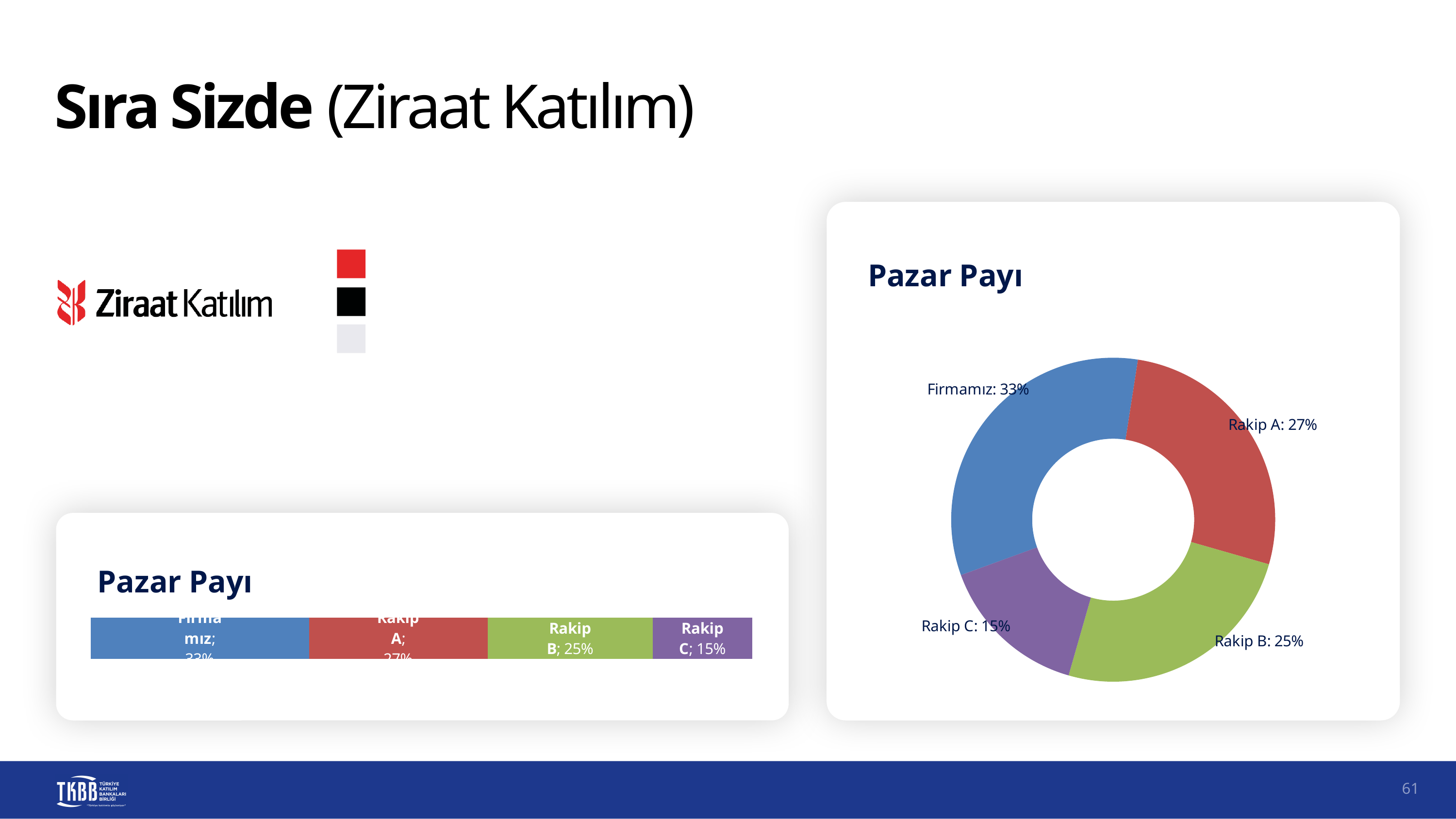
In the doughnut chart on the right, what is the share for Rakip C? 15% In the doughnut chart on the right, what is the difference in percentage points between Firmamız and Rakip C? 18 In the doughnut chart on the right, which category has the smallest share? Rakip C In the doughnut chart on the right, which is larger, Rakip A or Rakip B? Rakip A In the doughnut chart on the right, which category has the largest share? Firmamız In the bar chart on the bottom left, what is the value for Rakip B? 25% How many categories are shown in the doughnut chart on the right? 4 In the doughnut chart on the right, what is the share for Firmamız? 33% In the doughnut chart on the right, what is the share for Rakip B? 25% In the doughnut chart on the right, what is the share for Rakip A? 27% What is the title of the doughnut chart on the right? Pazar Payı What kind of chart is shown in the bottom-left panel? Bar chart